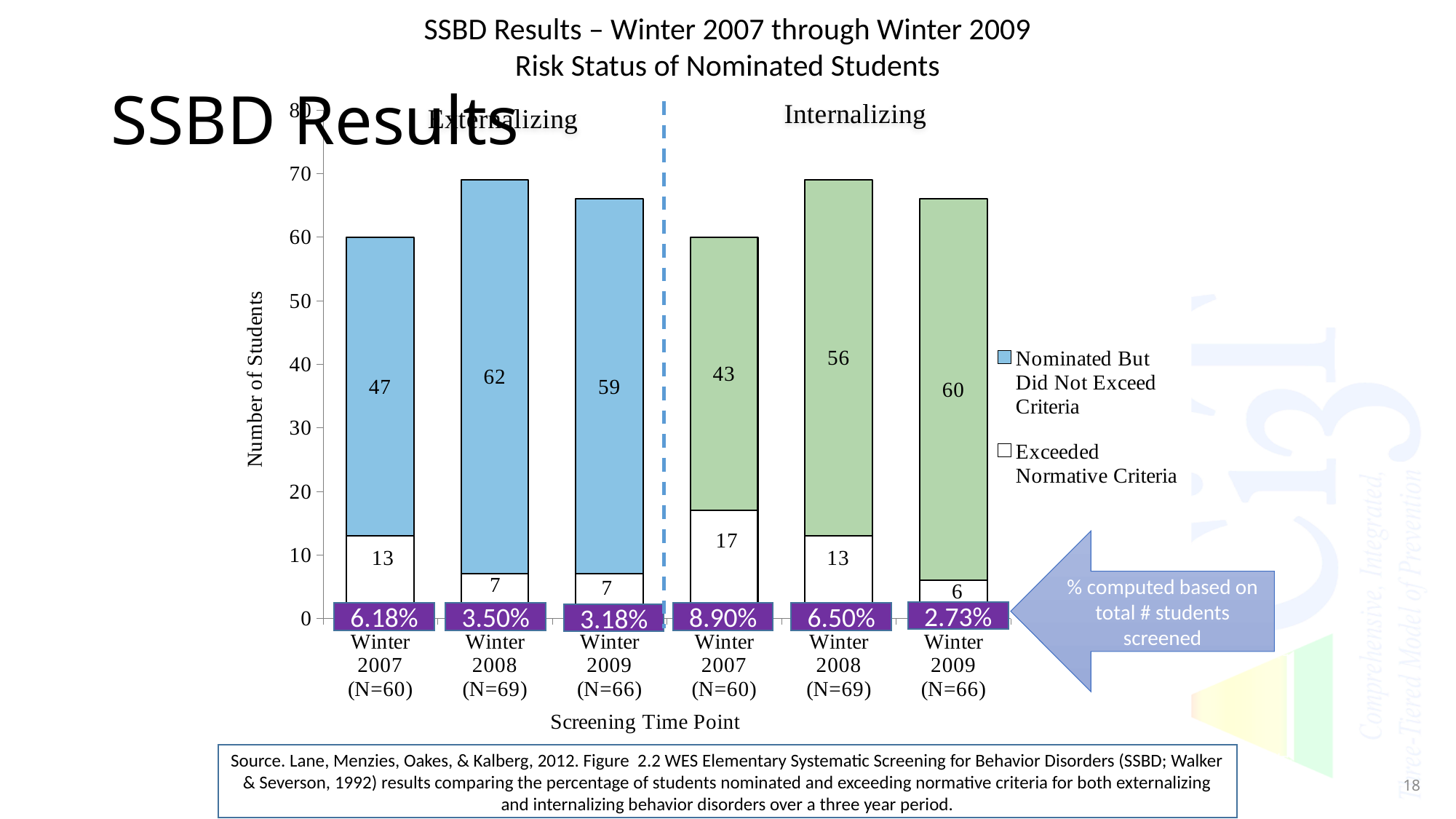
What is the value for Exceeded Normative Criteria for Externalizing Winter 2007? 13 How many bars are plotted in the chart? 6 What type of chart is shown on the slide? Stacked bar chart What is the difference between the Nominated But Did Not Exceed Criteria values for Externalizing Winter 2008 and Externalizing Winter 2007? 15 What is the value for Nominated But Did Not Exceed Criteria for Internalizing Winter 2008? 56 Which bar has the lowest Nominated But Did Not Exceed Criteria value? Internalizing Winter 2007 What is the y-axis title of the chart? Number of Students What is the total of the stacked bar for Externalizing Winter 2008? 69 What is the value for Exceeded Normative Criteria for Internalizing Winter 2009? 6 Which is larger, the Exceeded Normative Criteria value for Internalizing Winter 2008 or for Externalizing Winter 2009? Internalizing Winter 2008 How many series does the legend list? 2 Which bar has the highest Exceeded Normative Criteria value? Internalizing Winter 2007